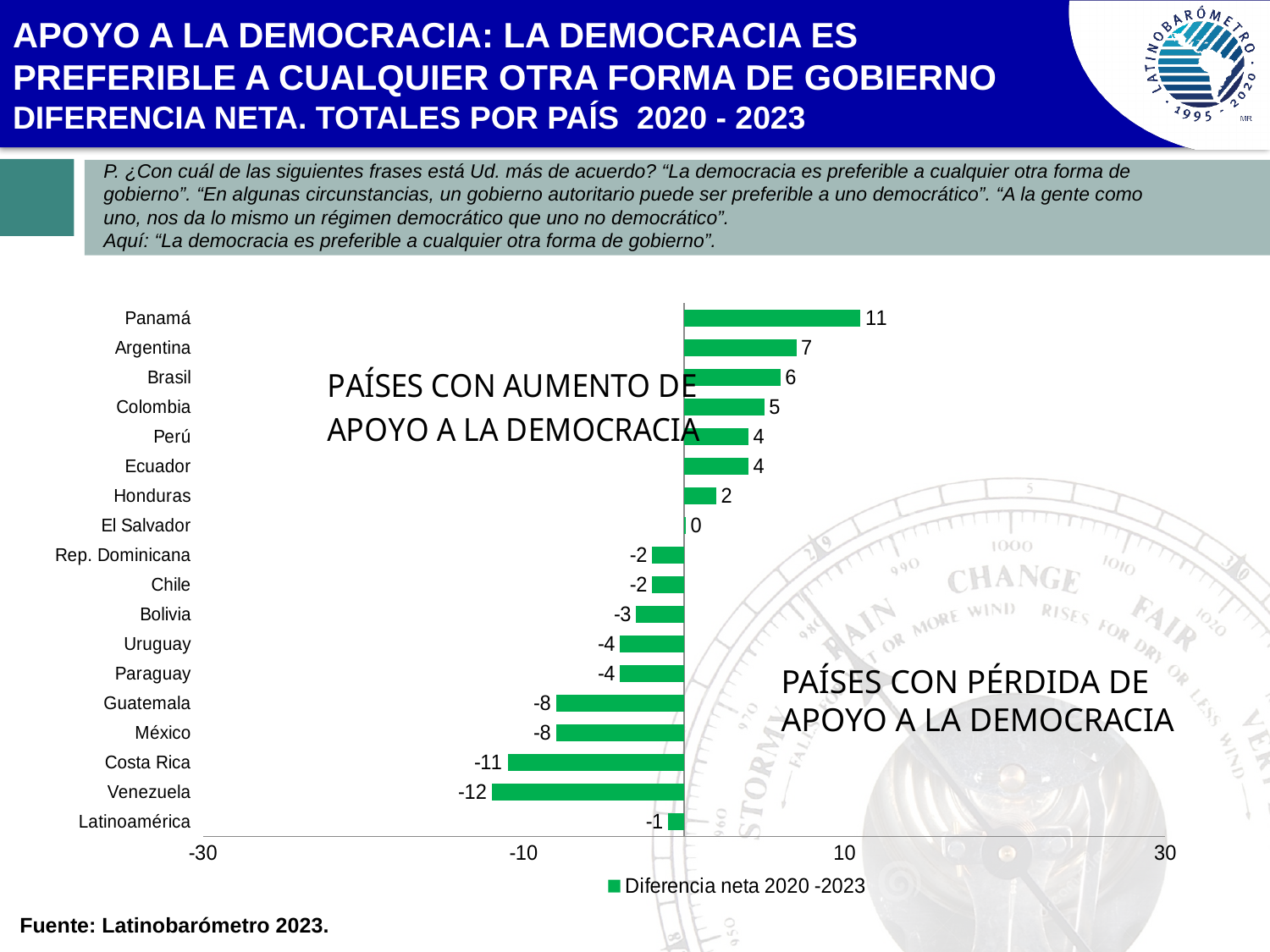
What is the net difference value for Venezuela? -12 How many categories are shown on the chart? 18 What is the net difference value for Latinoamérica? -1 Is the value for Costa Rica greater or less than -10? less What kind of chart is shown on the slide? bar chart Which has a larger net difference value, Brasil or Colombia? Brasil Which country has the highest net difference value? Panamá What is the legend entry of the chart? Diferencia neta 2020 -2023 How many series does the legend list? 1 Which country has the lowest net difference value? Venezuela What is the net difference value for Panamá? 11 What is the difference between the values for Panamá and Argentina? 4